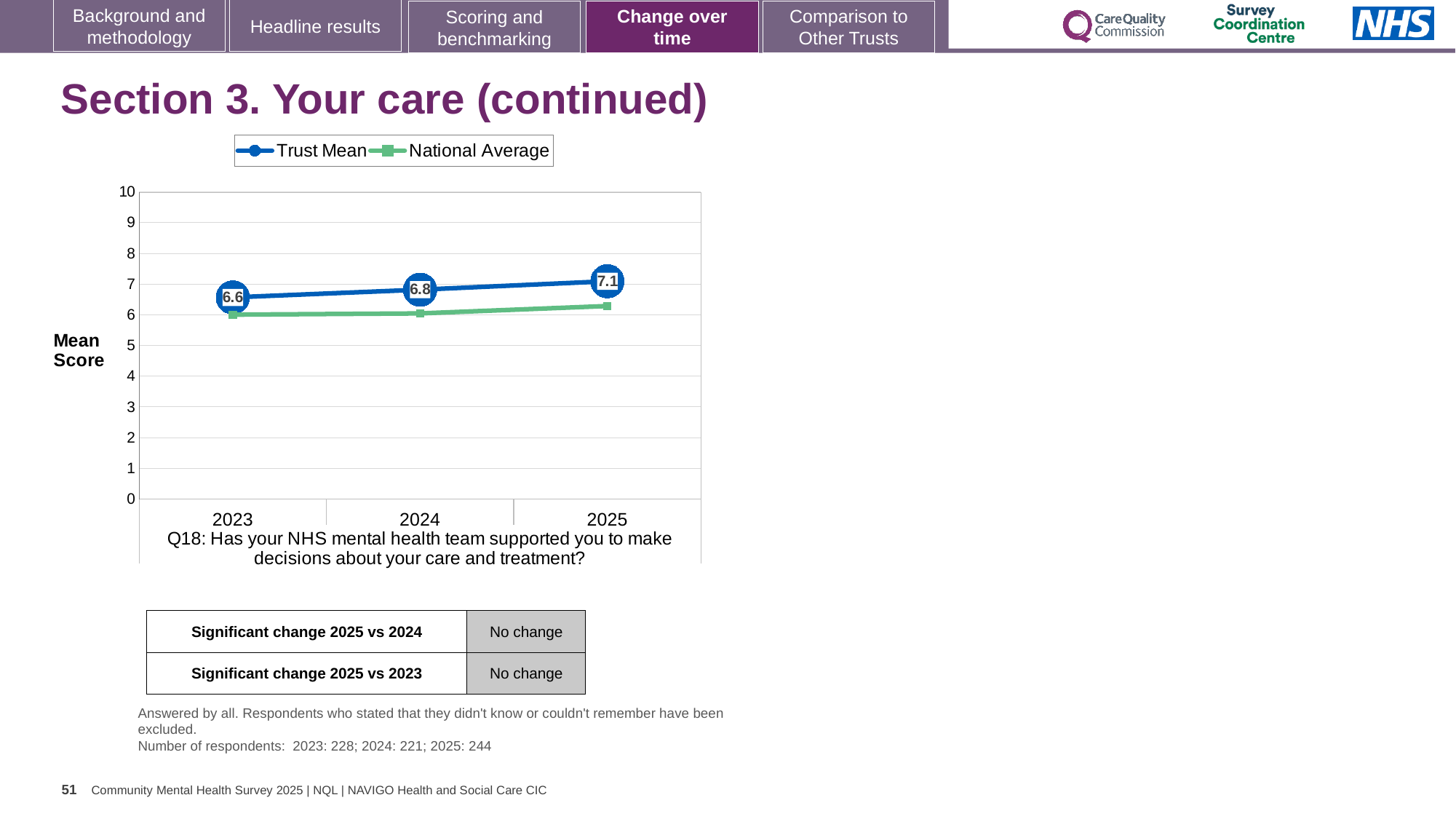
What is the Trust Mean score for 2025? 7.1 What is the Trust Mean score for 2023? 6.6 Is the National Average value for 2023 greater or less than 7? less Does the Trust Mean rise or fall from 2023 to 2025? rise Which is larger in 2025, the Trust Mean or the National Average? Trust Mean In which year is the Trust Mean lowest? 2023 What is the Trust Mean score for 2024? 6.8 How many years are shown on the x axis? 3 Is the National Average value for 2025 greater or less than 5? greater How many series does the legend list? 2 In which year is the Trust Mean highest? 2025 What is the difference between the Trust Mean in 2025 and in 2023? 0.5